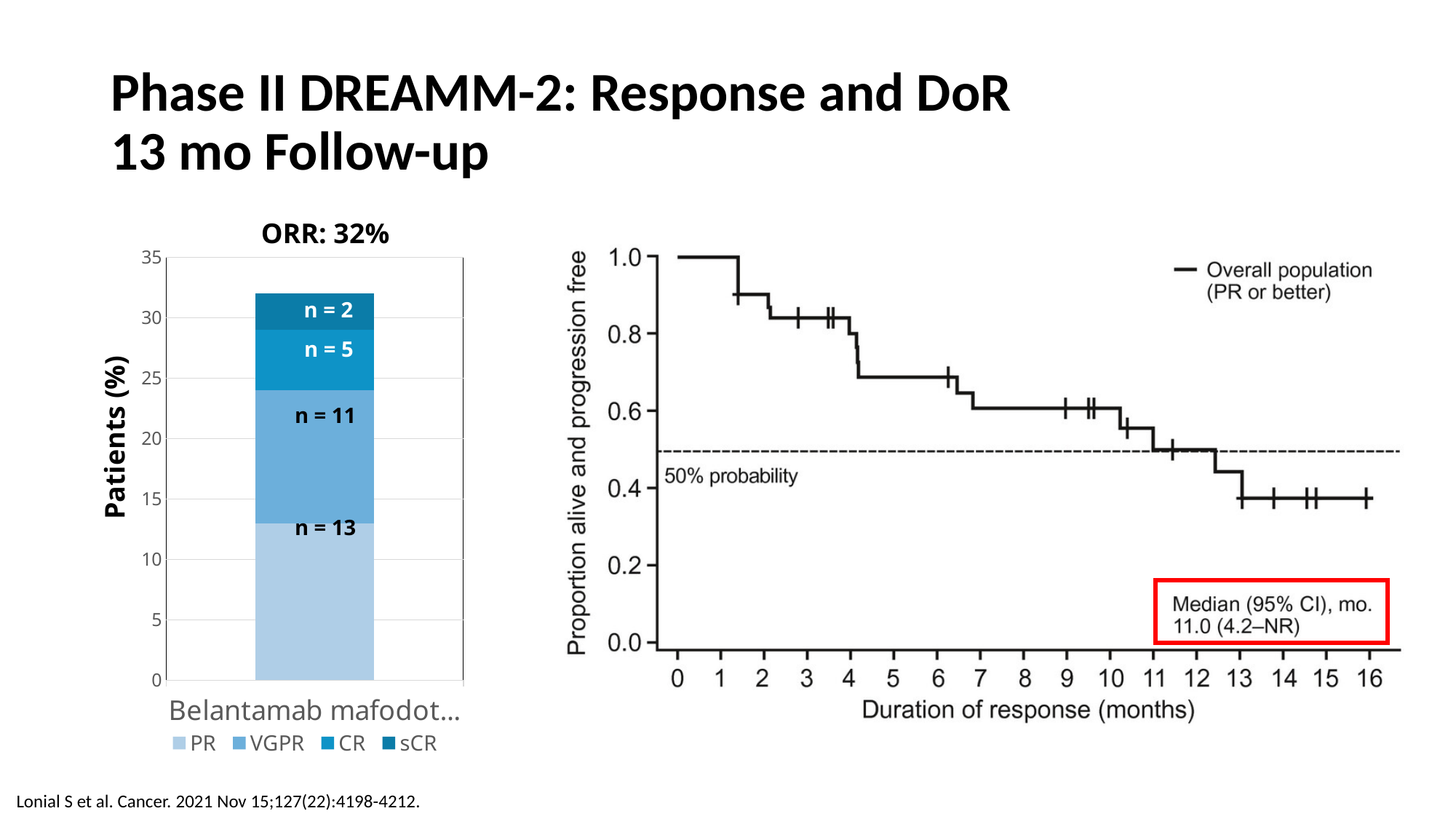
In the left bar chart, which response category has the smallest n? sCR In the left bar chart, what is the n value printed on the PR segment? n = 13 What kind of chart is the left chart showing response categories? bar chart In the left bar chart, what is the n value printed on the sCR segment? n = 2 In the right Kaplan-Meier chart, what is the 95% CI for the median duration of response? 4.2–NR In the left bar chart, which has a larger n, VGPR or CR? VGPR How many response categories does the legend of the left bar chart list? 4 In the left bar chart, which response category has the largest n? PR What ORR is printed above the left bar chart? 32% In the left bar chart, what is the difference between the n for PR and the n for VGPR? 2 In the right Kaplan-Meier chart, what is the median duration of response in months? 11.0 In the right Kaplan-Meier chart, is the proportion alive and progression free at 13 months greater or less than 0.5? less